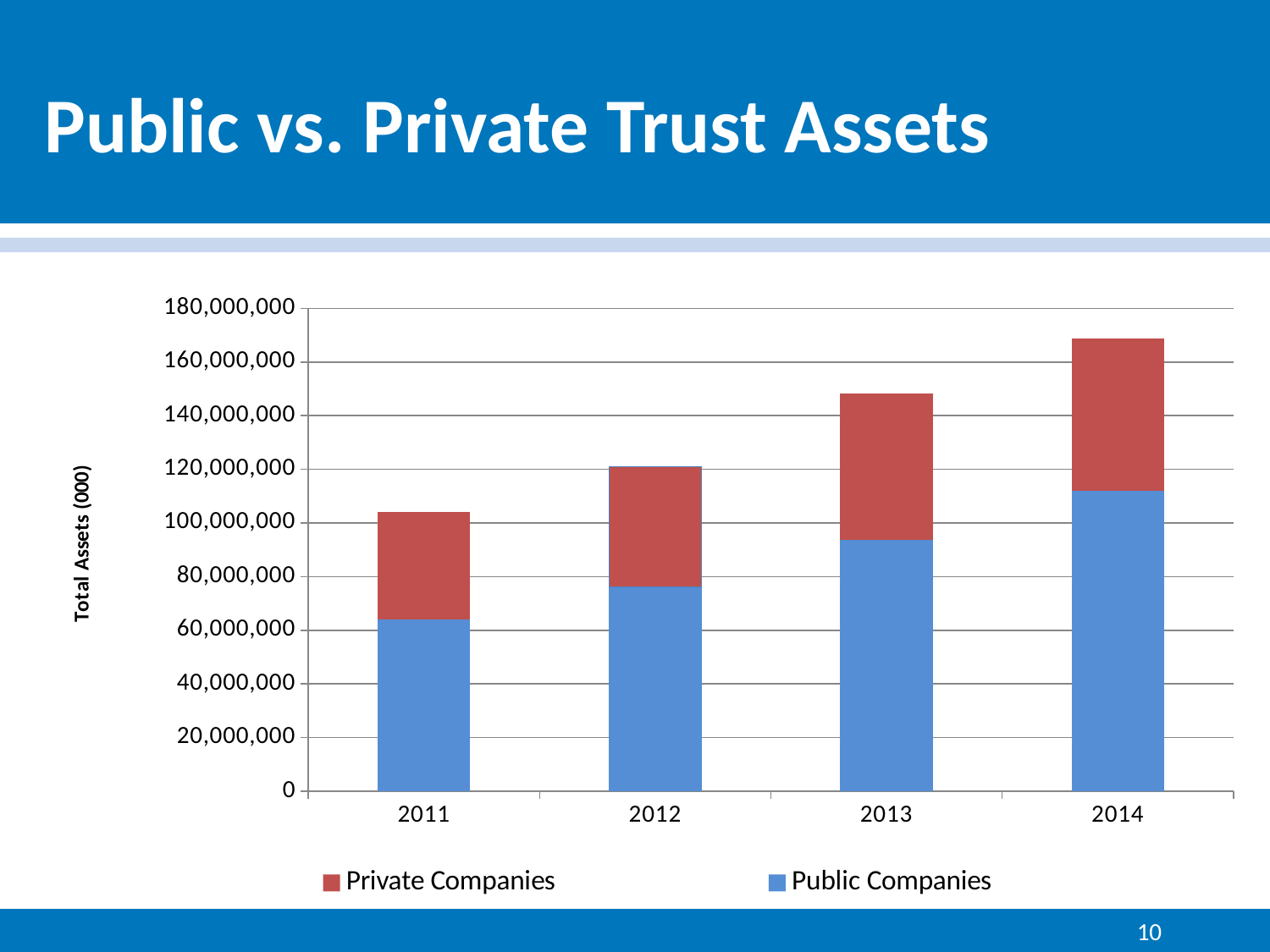
Is the value for Public Companies in 2013 greater or less than 100,000,000? less What is the title of the vertical axis? Total Assets (000) Which year has the highest total stacked bar? 2014 What kind of chart is shown on the slide? Stacked bar chart Which year has the lowest total stacked bar? 2011 How many years are shown on the x axis of the chart? 4 Is the value for Public Companies in 2011 greater or less than 60,000,000? greater How many series does the chart's legend list? 2 Is the total stacked bar for 2014 greater or less than 160,000,000? greater Do the total assets rise or fall from 2011 to 2014? Rise Which is larger, the Public Companies value in 2012 or in 2013? 2013